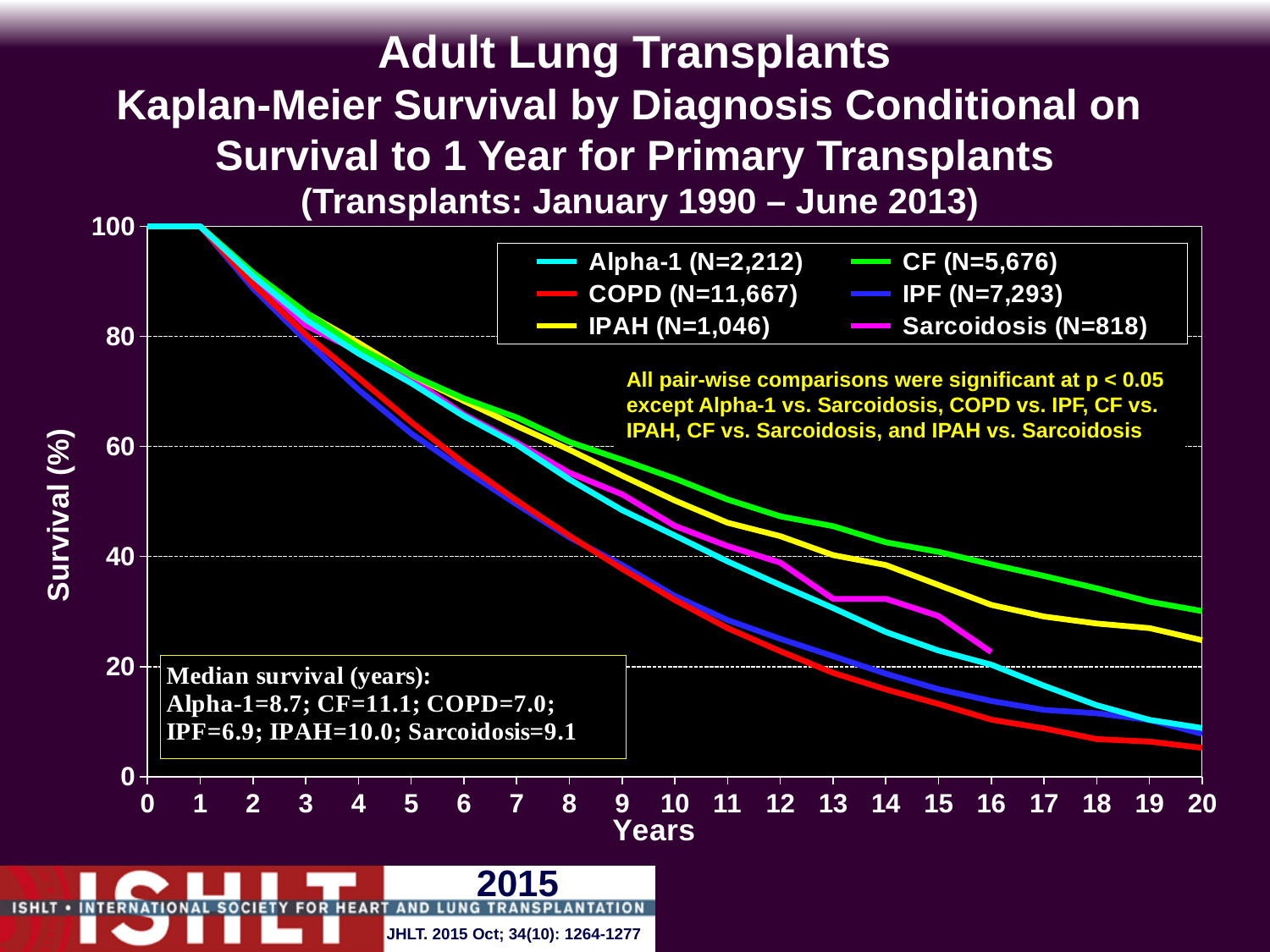
Which diagnosis has the highest survival at 20 years? CF Is the survival value for COPD at 20 years greater or less than 20? less What is the N for COPD shown in the legend? 11,667 How many series does the legend list? 6 What is the difference between the median survival of CF and IPF in years? 4.2 Is the survival value for IPF at 10 years greater or less than 40? less What kind of chart is shown on the slide? line chart At 15 years, which has higher survival, CF or COPD? CF Which diagnosis has the lowest survival at 20 years? COPD What is the median survival in years for CF according to the text box? 11.1 Do the survival curves rise or fall as years increase? fall Is the survival value for CF at 20 years greater or less than 20? greater